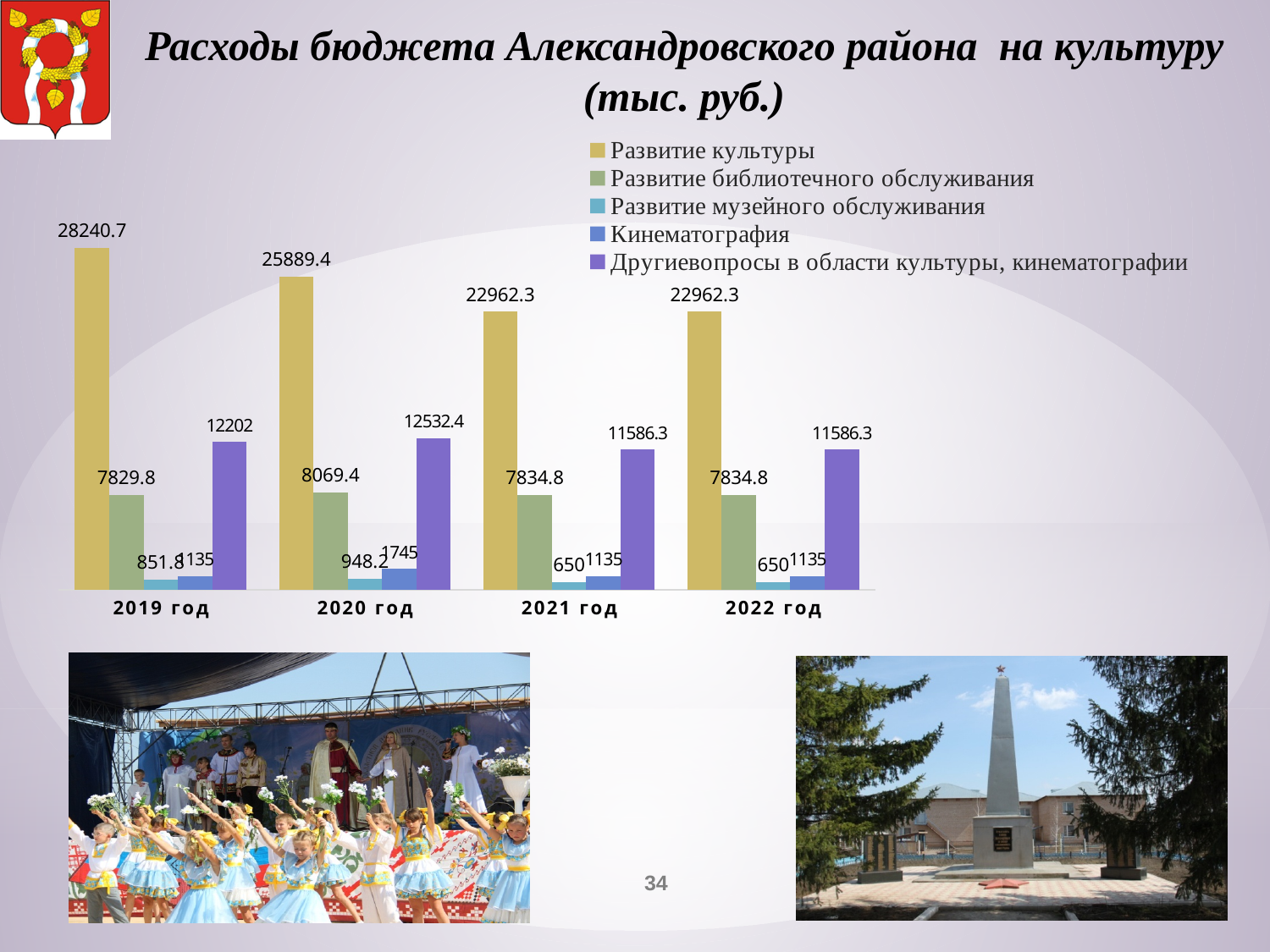
How many series does the legend list? 5 Does the value for Развитие культуры rise or fall from 2019 год to 2021 год? fall What is the value for Развитие библиотечного обслуживания in 2020 год? 8069.4 In which year is the value for Развитие культуры highest? 2019 год What is the difference between the Развитие культуры values for 2019 год and 2020 год? 2351.3 What is the value for Другиевопросы в области культуры, кинематографии in 2021 год? 11586.3 What is the value for Кинематография in 2020 год? 1745 What is the value for Развитие культуры in 2019 год? 28240.7 How many year categories are shown on the x axis? 4 Which is larger: Другиевопросы в области культуры, кинематографии in 2020 год or in 2019 год? 2020 год What type of chart is shown on the slide? bar chart What is the value for Развитие музейного обслуживания in 2022 год? 650